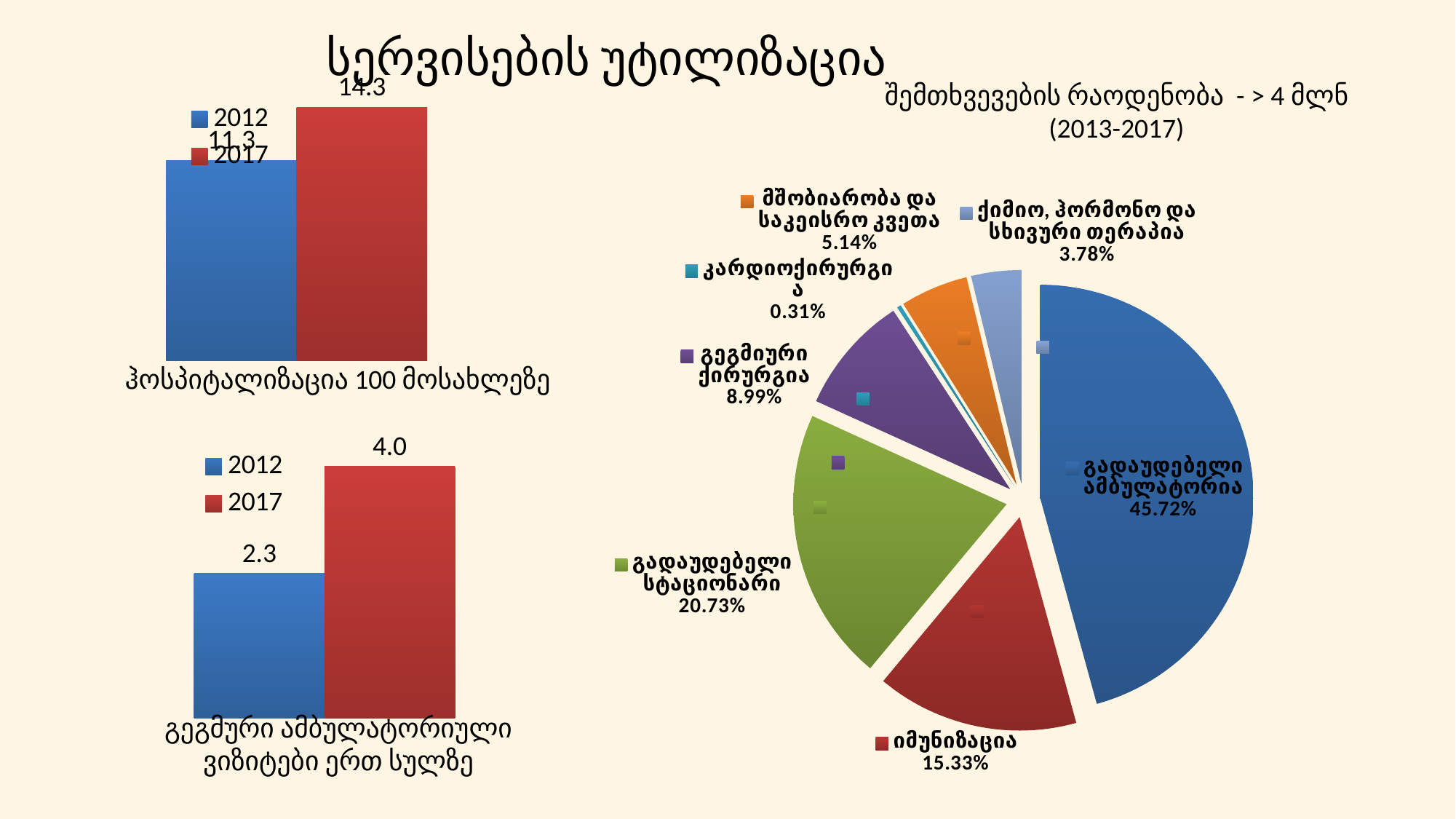
In the bottom-left bar chart (გეგმური ამბულატორიული ვიზიტები ერთ სულზე), what is the value for 2017? 4.0 What kind of chart is the chart on the right side of the slide? Pie chart In the top-left bar chart (ჰოსპიტალიზაცია 100 მოსახლეზე), what is the difference between the 2017 and 2012 values? 3.0 In the bottom-left bar chart (გეგმური ამბულატორიული ვიზიტები ერთ სულზე), which year has the higher value, 2012 or 2017? 2017 How many series does the legend of the bottom-left bar chart list? 2 In the pie chart on the right, which slice is the smallest? კარდიოქირურგია In the pie chart on the right, what share does გადაუდებელი ამბულატორია have? 45.72% In the top-left bar chart (ჰოსპიტალიზაცია 100 მოსახლეზე), what is the value for 2017? 14.3 In the pie chart on the right, what is the share of იმუნიზაცია? 15.33% In the top-left bar chart (ჰოსპიტალიზაცია 100 მოსახლეზე), what is the value for 2012? 11.3 In the bottom-left bar chart (გეგმური ამბულატორიული ვიზიტები ერთ სულზე), what is the value for 2012? 2.3 How many slices does the pie chart on the right have? 7